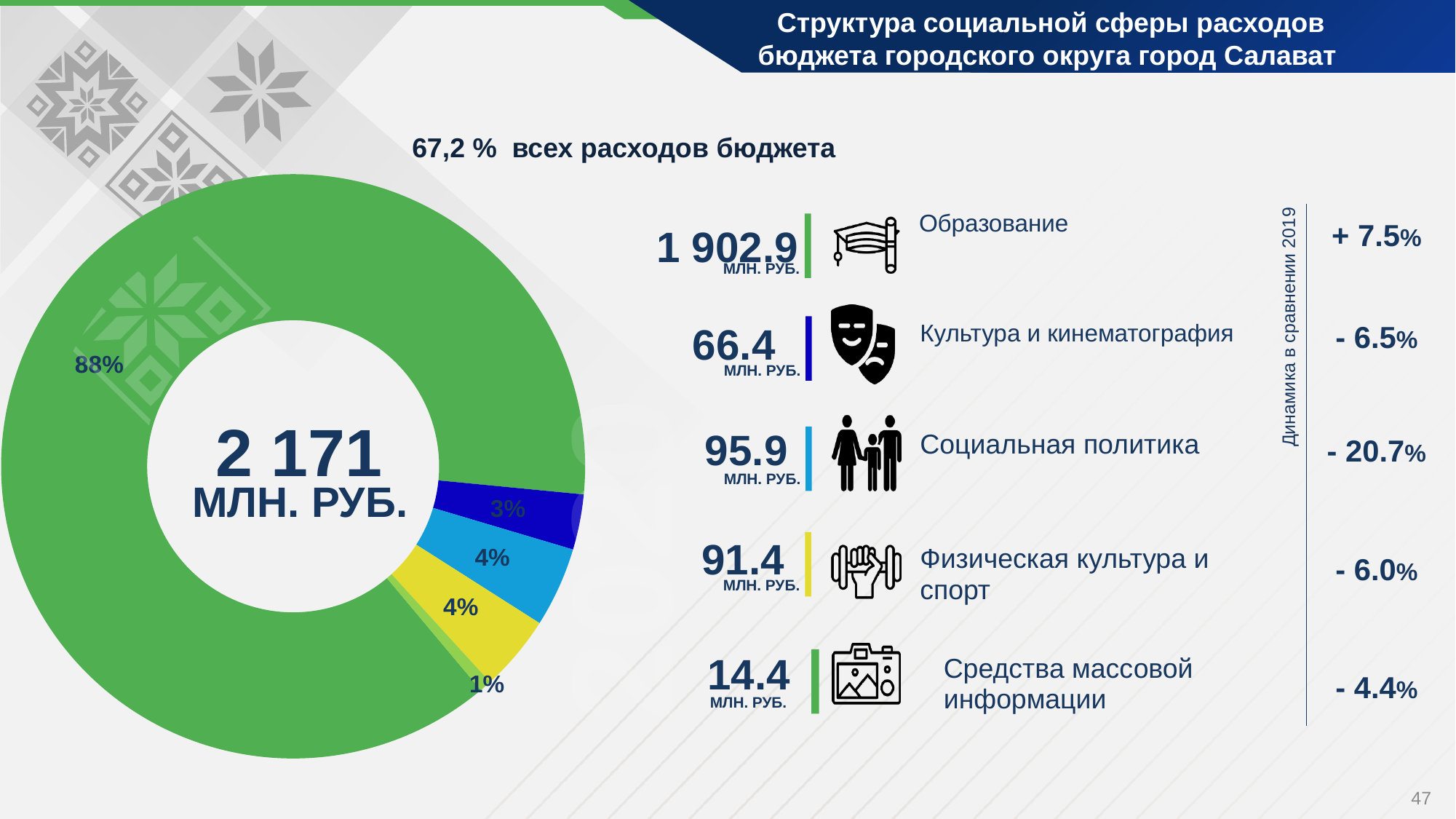
How many slices does the donut chart have? 5 What is the total value shown in the centre of the donut chart? 2 171 млн. руб. What is the value for Культура и кинематография in млн. руб.? 66.4 What is the change compared to 2019 shown for Социальная политика? - 20.7% What share of the donut chart does the largest slice (Образование) take? 88% Which category has the largest slice in the donut chart? Образование What is the value for Социальная политика in млн. руб.? 95.9 What is the difference between the values for Социальная политика (95.9) and Физическая культура и спорт (91.4) in млн. руб.? 4.5 What is the value for Образование in млн. руб.? 1 902.9 What kind of chart is shown on the slide? Donut (pie) chart Which category has the smallest slice in the donut chart? Средства массовой информации Which is larger: the value for Социальная политика or the value for Физическая культура и спорт? Социальная политика